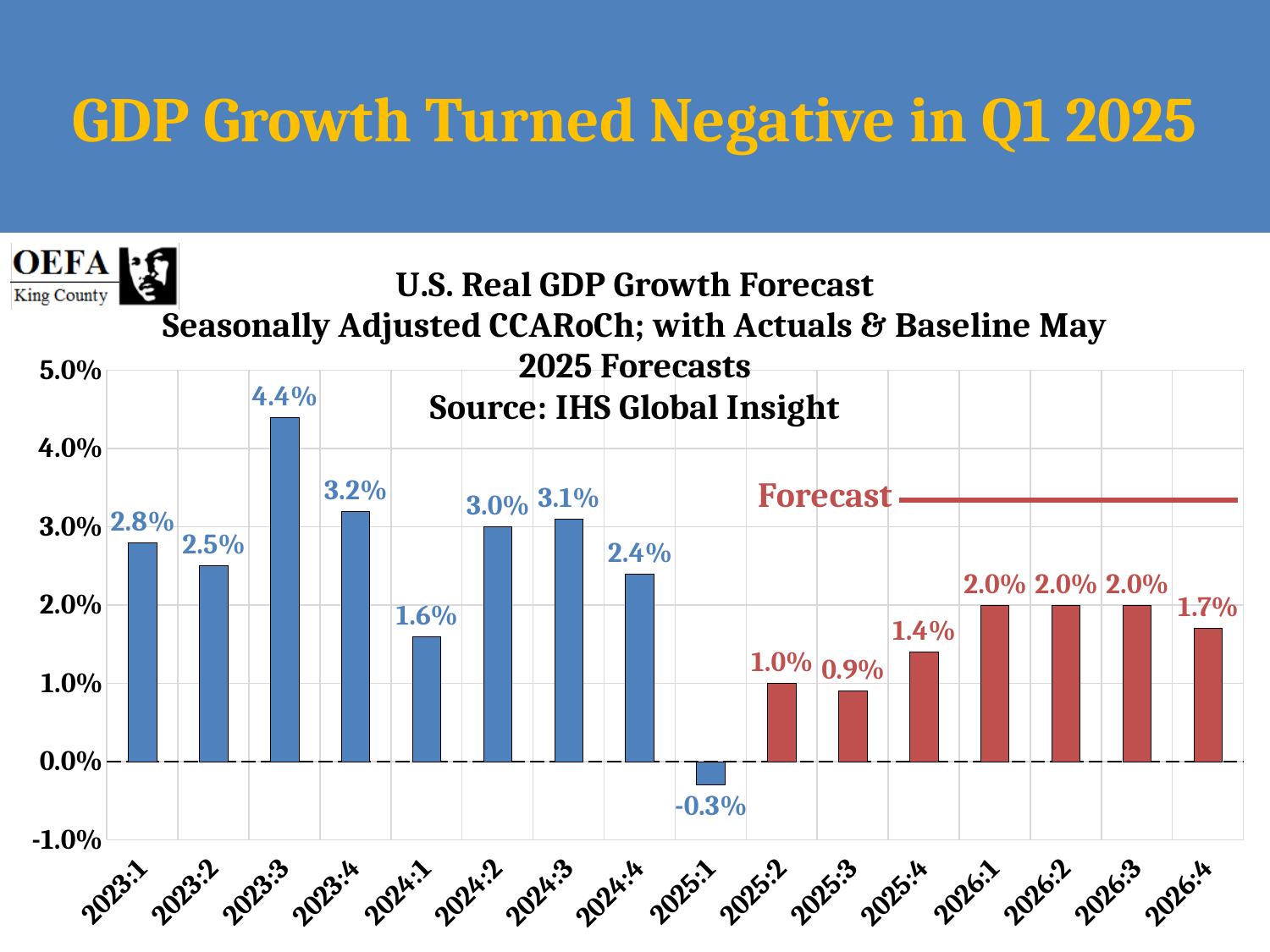
What is the GDP growth value for 2025:1? -0.3% What is the GDP growth value for 2023:3? 4.4% What is the forecast GDP growth value for 2026:4? 1.7% Is the GDP growth value for 2025:3 greater or less than 1.0%? less What colour are the forecast bars? red What kind of chart is shown on the slide? bar chart How many quarters are shown on the x axis? 16 Which is larger, the GDP growth value for 2024:4 or for 2025:4? 2024:4 Which quarter has the highest GDP growth value? 2023:3 Which quarter has the lowest GDP growth value? 2025:1 Do the forecast values rise or fall from 2025:2 to 2026:1? rise What is the difference between the GDP growth values for 2023:3 and 2024:1? 2.8%